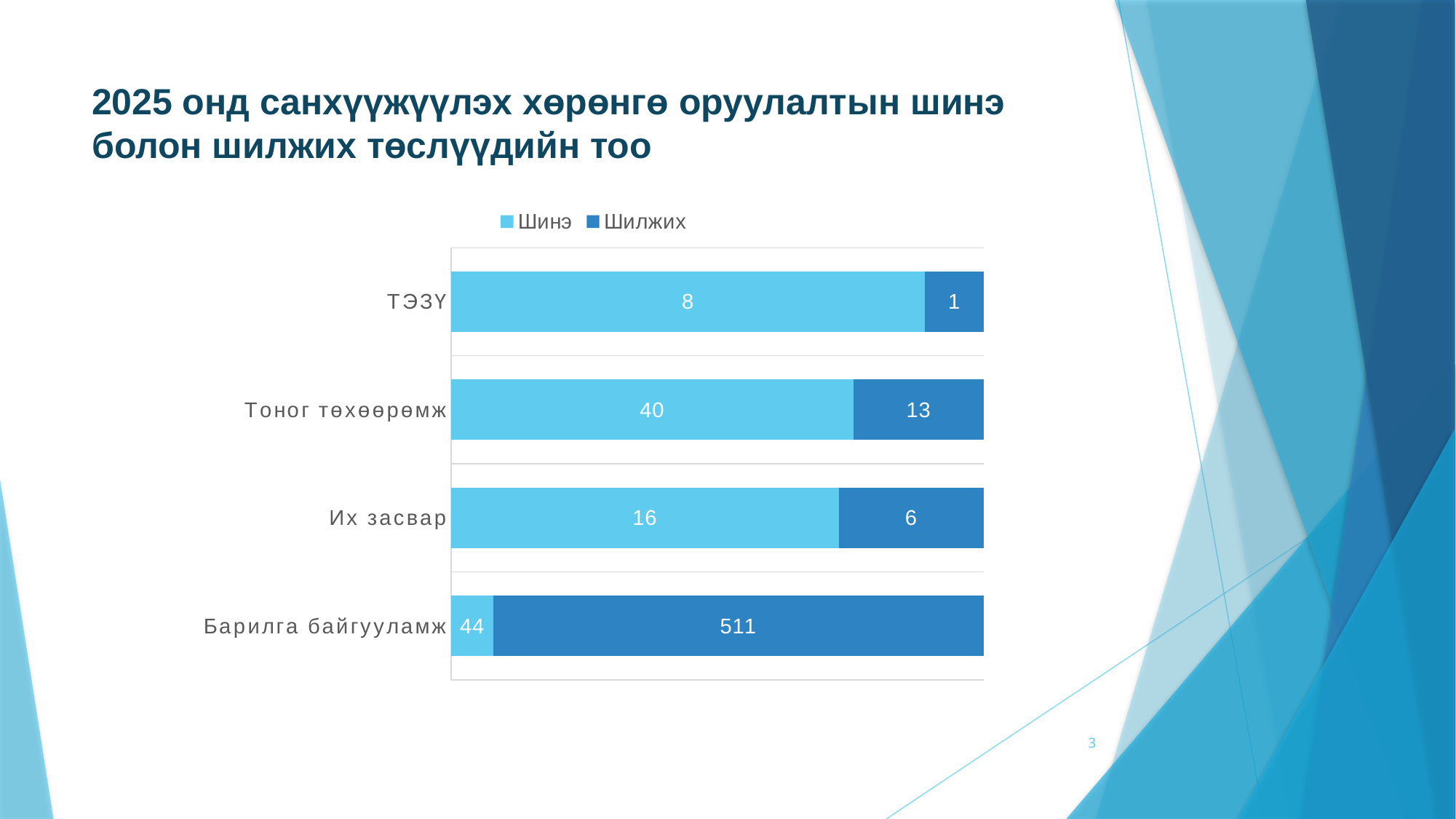
Which is larger for Их засвар, the Шинэ value or the Шилжих value? Шинэ How many series does the legend list? 2 Which category has the lowest Шинэ value? ТЭЗҮ What is the total of the Шинэ and Шилжих values for Барилга байгууламж? 555 What kind of chart is shown on the slide? Stacked bar chart What is the Шилжих value for Барилга байгууламж? 511 How many categories are shown in the chart? 4 What is the difference between the Шинэ and Шилжих values for Тоног төхөөрөмж? 27 Which category has the highest Шилжих value? Барилга байгууламж What is the Шилжих value for ТЭЗҮ? 1 What is the Шинэ value for Тоног төхөөрөмж? 40 What is the Шинэ value for Их засвар? 16